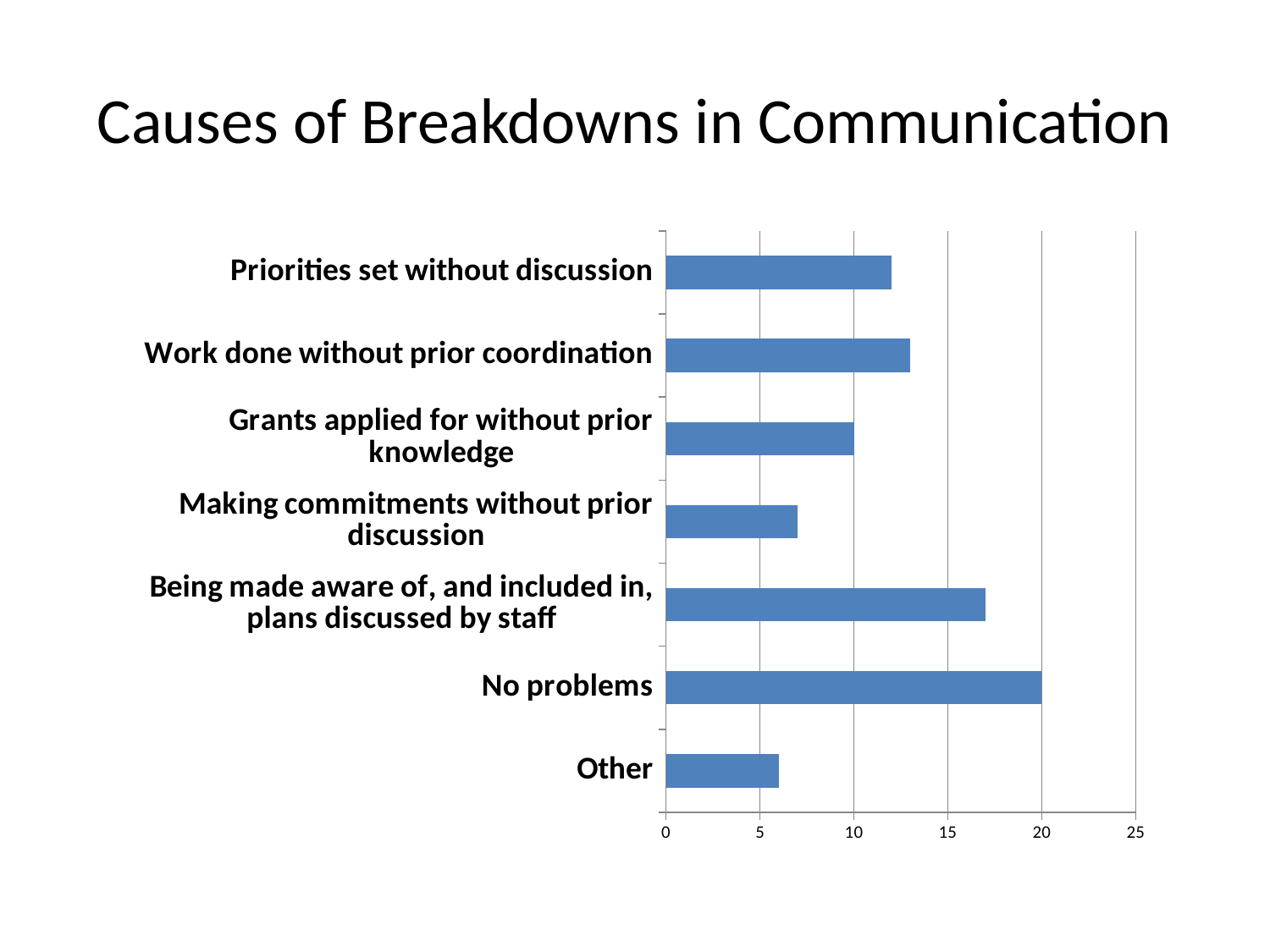
What is the title of the chart? Causes of Breakdowns in Communication Which is larger, the value for Being made aware of, and included in, plans discussed by staff or the value for Priorities set without discussion? Being made aware of, and included in, plans discussed by staff Which category has the lowest value? Other How many categories are shown in the chart? 7 Which category has the highest value? No problems What type of chart is shown on the slide? Bar chart What is the value for Grants applied for without prior knowledge? 10 Is the value for Making commitments without prior discussion greater or less than 10? less Is the value for Being made aware of, and included in, plans discussed by staff greater or less than 15? greater What is the value for No problems? 20 What is the difference between the value for No problems and the value for Grants applied for without prior knowledge? 10 Is the value for Priorities set without discussion greater or less than 10? greater